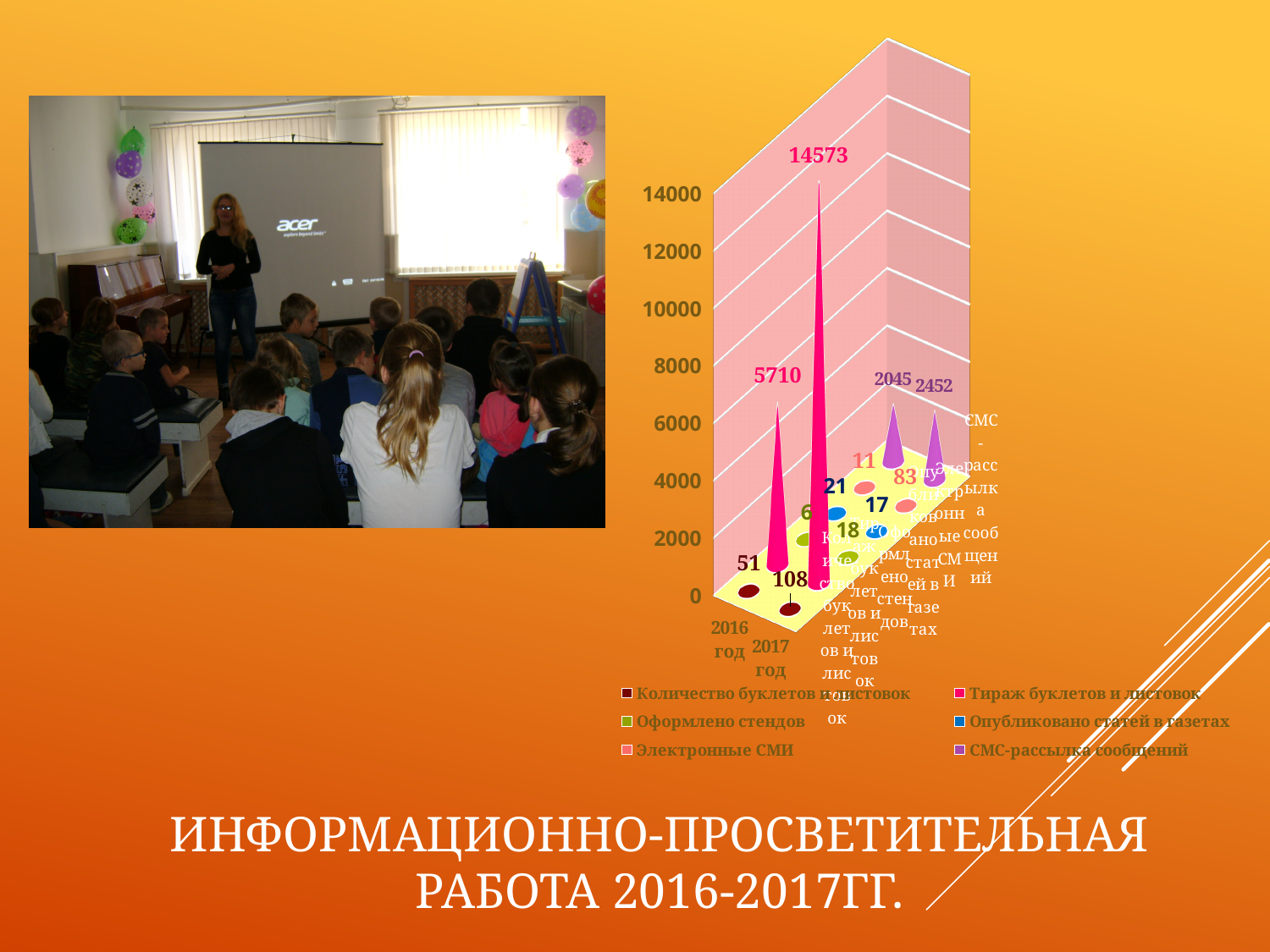
What is the value of Опубликовано статей в газетах for 2016 год? 21 What is the value of Тираж буклетов и листовок for 2017 год? 14573 Which year has the larger value for Опубликовано статей в газетах, 2016 год or 2017 год? 2016 год By how much did Тираж буклетов и листовок increase from 2016 год to 2017 год? 8863 What is the difference between the СМС-рассылка сообщений values for 2017 год and 2016 год? 407 How many series does the legend list? 6 What is the value of Тираж буклетов и листовок for 2016 год? 5710 What is the value of СМС-рассылка сообщений for 2016 год? 2045 What is the value of Электронные СМИ for 2017 год? 83 Which series has the highest value in 2017 год? Тираж буклетов и листовок How many year categories are shown on the chart? 2 What is the value of Количество буклетов и листовок for 2017 год? 108